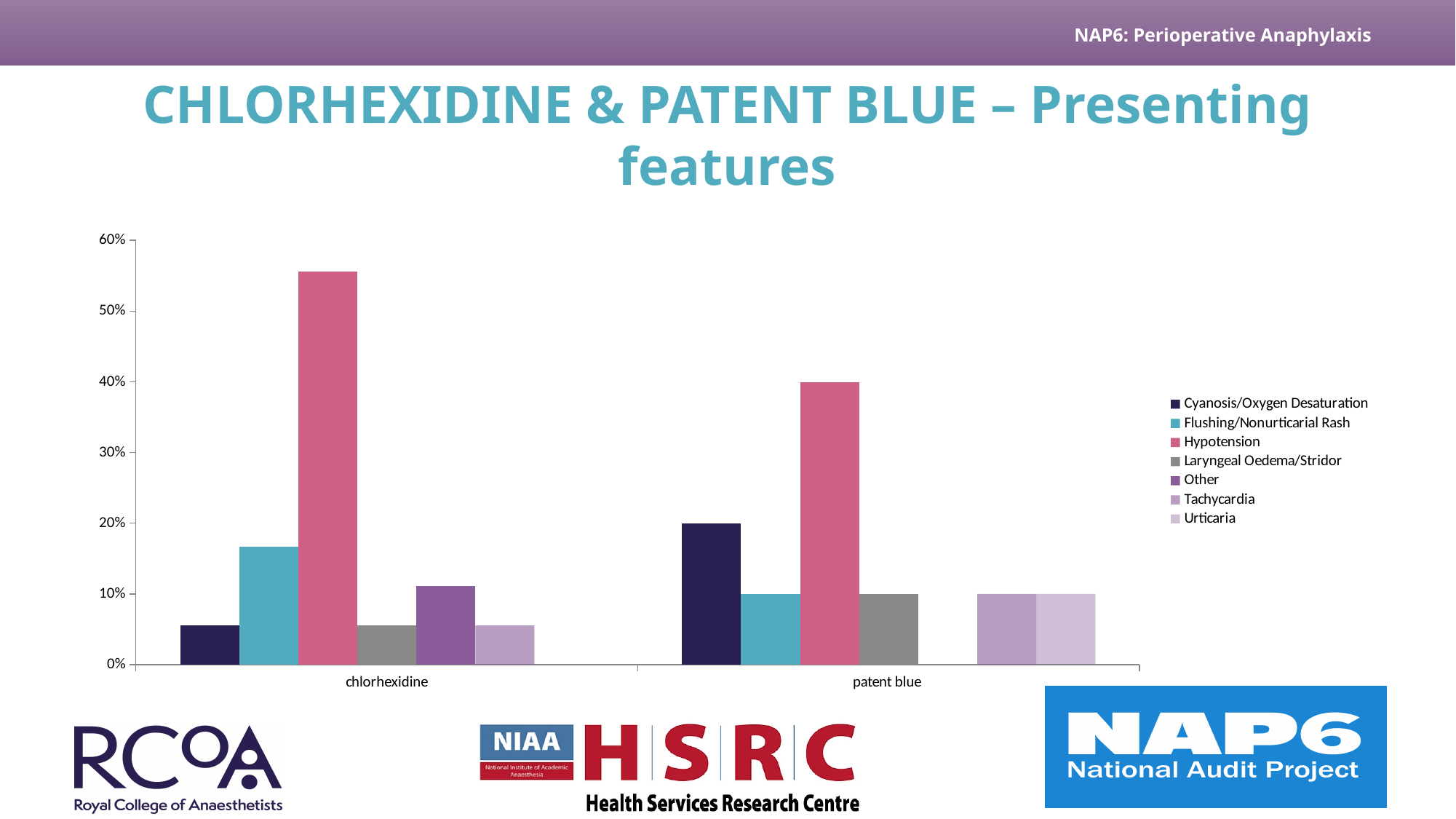
How many series does the legend list? 7 Which presenting feature has the highest value for chlorhexidine? Hypotension What kind of chart is shown on the slide? bar chart Is the value for Flushing/Nonurticarial Rash for chlorhexidine greater or less than 20%? less What is the value for Hypotension for patent blue? 40% How many categories are shown on the x axis? 2 What is the value for Cyanosis/Oxygen Desaturation for patent blue? 20% Which is larger: Hypotension for chlorhexidine or Hypotension for patent blue? Hypotension for chlorhexidine Is the value for Other for chlorhexidine greater or less than 10%? greater Is the value for Hypotension for chlorhexidine greater or less than 50%? greater Which colour represents Hypotension in the legend? pink Which presenting feature has the highest value for patent blue? Hypotension